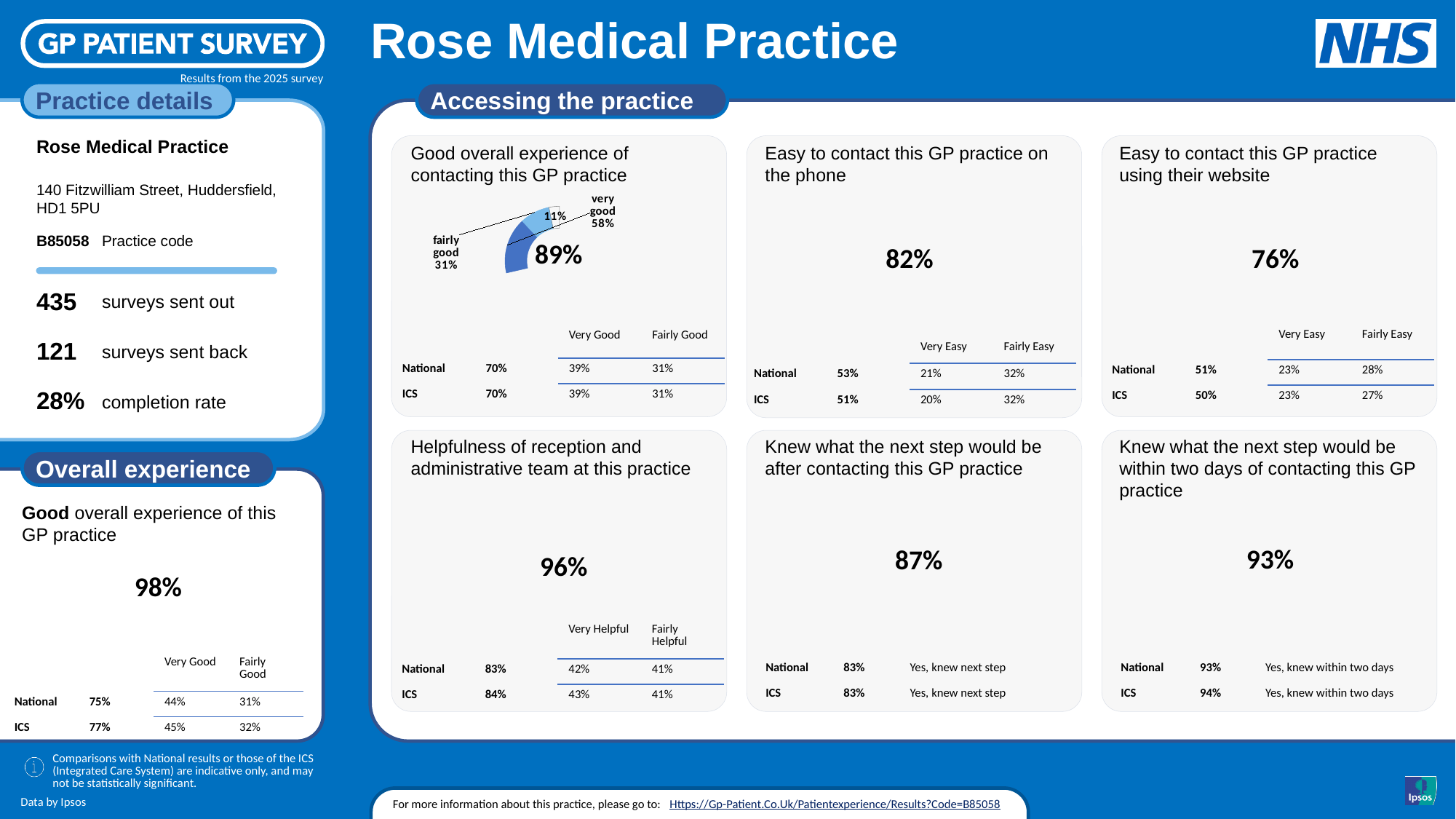
In the 'Good overall experience of contacting this GP practice' chart, what is the smallest percentage labelled on a slice? 11% What kind of chart is used in the 'Good overall experience of contacting this GP practice' panel? doughnut chart In the 'Good overall experience of contacting this GP practice' chart, which labelled slice is the largest? very good In the 'Good overall experience of contacting this GP practice' chart, which is larger, 'very good' or 'fairly good'? very good In the 'Good overall experience of contacting this GP practice' chart, what percentage is shown for 'very good'? 58% In the 'Good overall experience of contacting this GP practice' chart, what is the combined percentage of 'very good' and 'fairly good'? 89% What large figure is printed in the centre of the 'Good overall experience of contacting this GP practice' chart? 89% In the 'Good overall experience of contacting this GP practice' chart, what is the difference between the 'very good' and 'fairly good' percentages? 27% In the 'Good overall experience of contacting this GP practice' chart, what percentage is shown for 'fairly good'? 31% In the 'Good overall experience of contacting this GP practice' chart, is the 'very good' share greater or less than 50%? greater How many slices with percentage labels are shown in the 'Good overall experience of contacting this GP practice' chart? 3